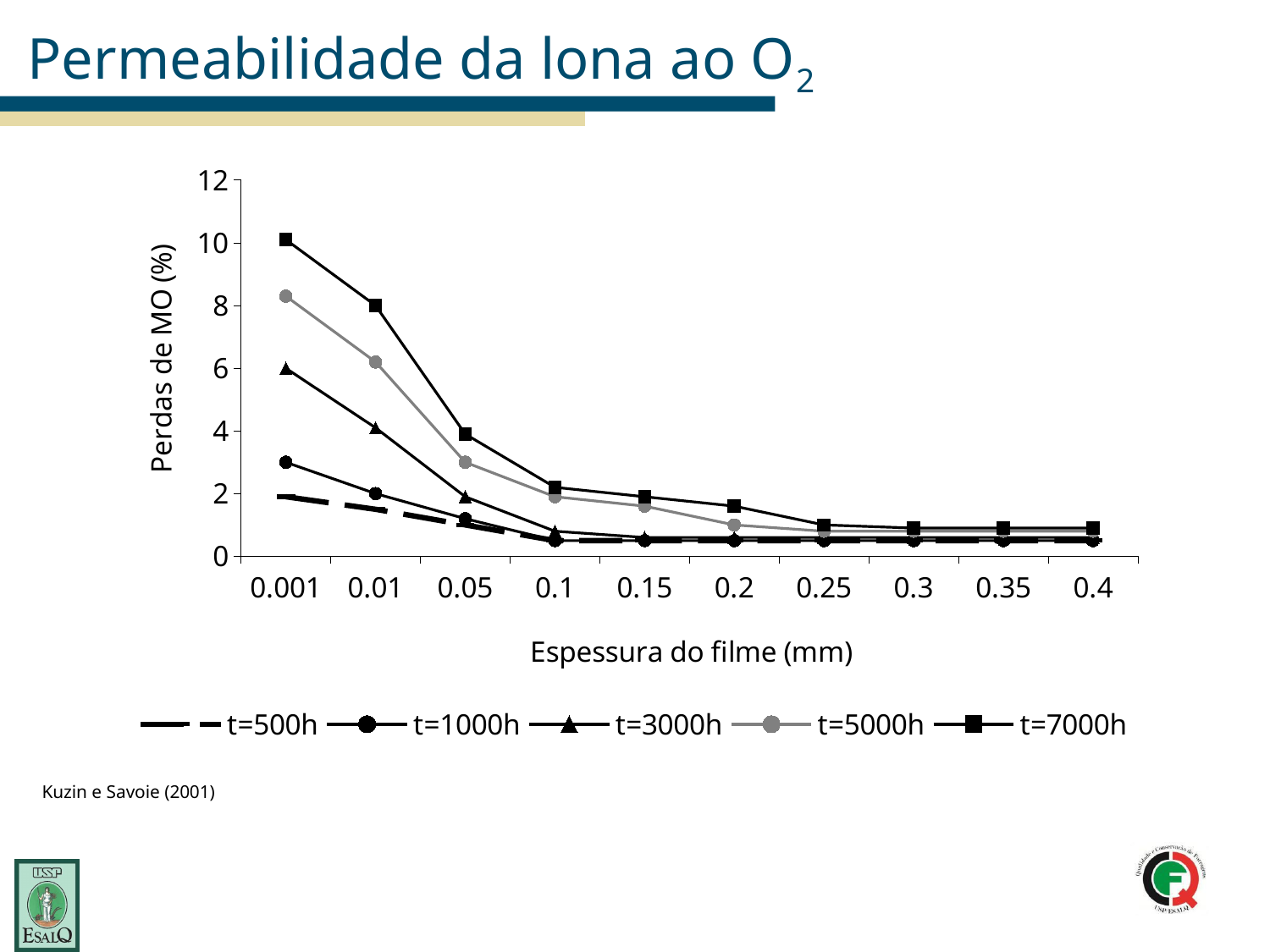
Is the value for t=5000h at 0.05 mm greater or less than 4? less What is the title of the x axis? Espessura do filme (mm) How many series does the legend list? 5 Which series has the highest value at a film thickness of 0.001 mm? t=7000h How many film thickness values are shown on the x axis? 10 Do the values for t=7000h rise or fall as film thickness increases along the x axis? fall Which series has the lowest value at a film thickness of 0.001 mm? t=500h What is the title of the y axis? Perdas de MO (%) What kind of chart is shown on the slide? line chart At a film thickness of 0.01 mm, which is larger: t=7000h or t=3000h? t=7000h Is the value for t=7000h at 0.001 mm greater or less than 8? greater Is the value for t=1000h at 0.001 mm greater or less than 2? greater